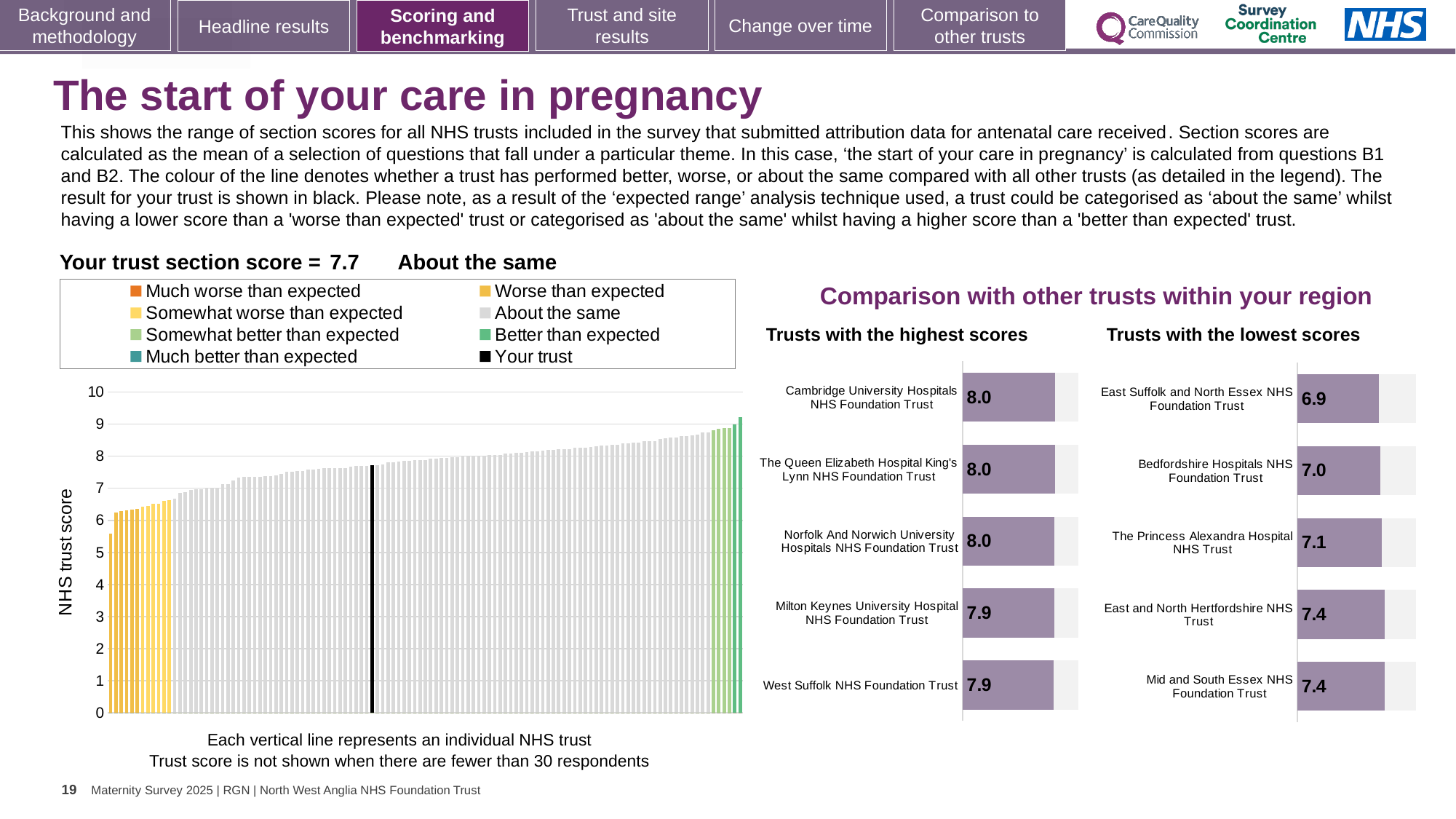
In the 'NHS trust score' chart on the left, do the bar values rise or fall from left to right? Rise In the 'Trusts with the lowest scores' chart, what is the difference between the score for Mid and South Essex NHS Foundation Trust and the score for East Suffolk and North Essex NHS Foundation Trust? 0.5 In the 'NHS trust score' chart on the left, is the value of the black 'Your trust' bar greater or less than 7? greater How many trusts are listed in the 'Trusts with the highest scores' chart? 5 In the 'Trusts with the lowest scores' chart, what is the score for Bedfordshire Hospitals NHS Foundation Trust? 7.0 In the 'Trusts with the lowest scores' chart, which has the higher score: Bedfordshire Hospitals NHS Foundation Trust or The Princess Alexandra Hospital NHS Trust? The Princess Alexandra Hospital NHS Trust In the 'Trusts with the highest scores' chart, what score is shown for West Suffolk NHS Foundation Trust? 7.9 What is the section score for your trust shown above the 'NHS trust score' chart? 7.7 In the 'Trusts with the highest scores' chart, what is the score for Milton Keynes University Hospital NHS Foundation Trust? 7.9 What type of chart is the large 'NHS trust score' chart on the left of the slide? Bar chart How many entries does the legend above the 'NHS trust score' chart list? 8 In the 'Trusts with the lowest scores' chart, which trust has the lowest score? East Suffolk and North Essex NHS Foundation Trust